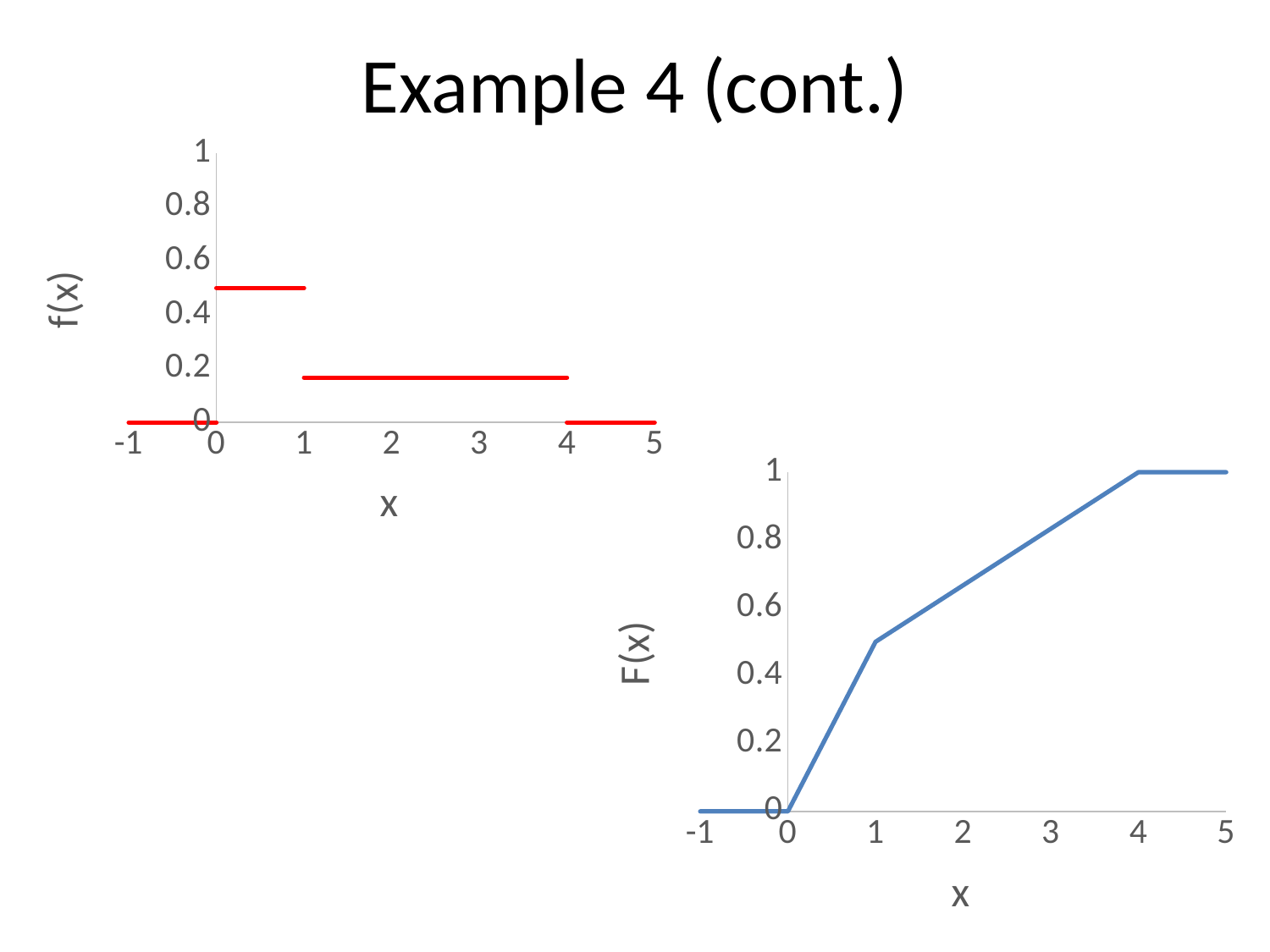
In the top-left f(x) chart, is the value of f(x) at x = 3 greater or less than 0.2? less What kind of chart is the bottom-right chart titled with y-axis F(x)? line chart In the bottom-right F(x) chart, what is the value of F(x) at x = -1? 0 In the top-left f(x) chart, is the value of f(x) at x = 0.5 greater or less than 0.4? greater What colour is the line in the top-left f(x) chart? red In the top-left f(x) chart, what is the value of f(x) at x = 5? 0 In the bottom-right F(x) chart, is the value of F(x) at x = 1 greater or less than 0.4? greater In the top-left f(x) chart, is the value of f(x) larger between x = 0 and 1 or between x = 1 and 4? between x = 0 and 1 In the bottom-right F(x) chart, what is the value of F(x) at x = 4? 1 In the bottom-right F(x) chart, does F(x) rise or fall as x increases from 0 to 4? rise How many charts are shown on the slide? 2